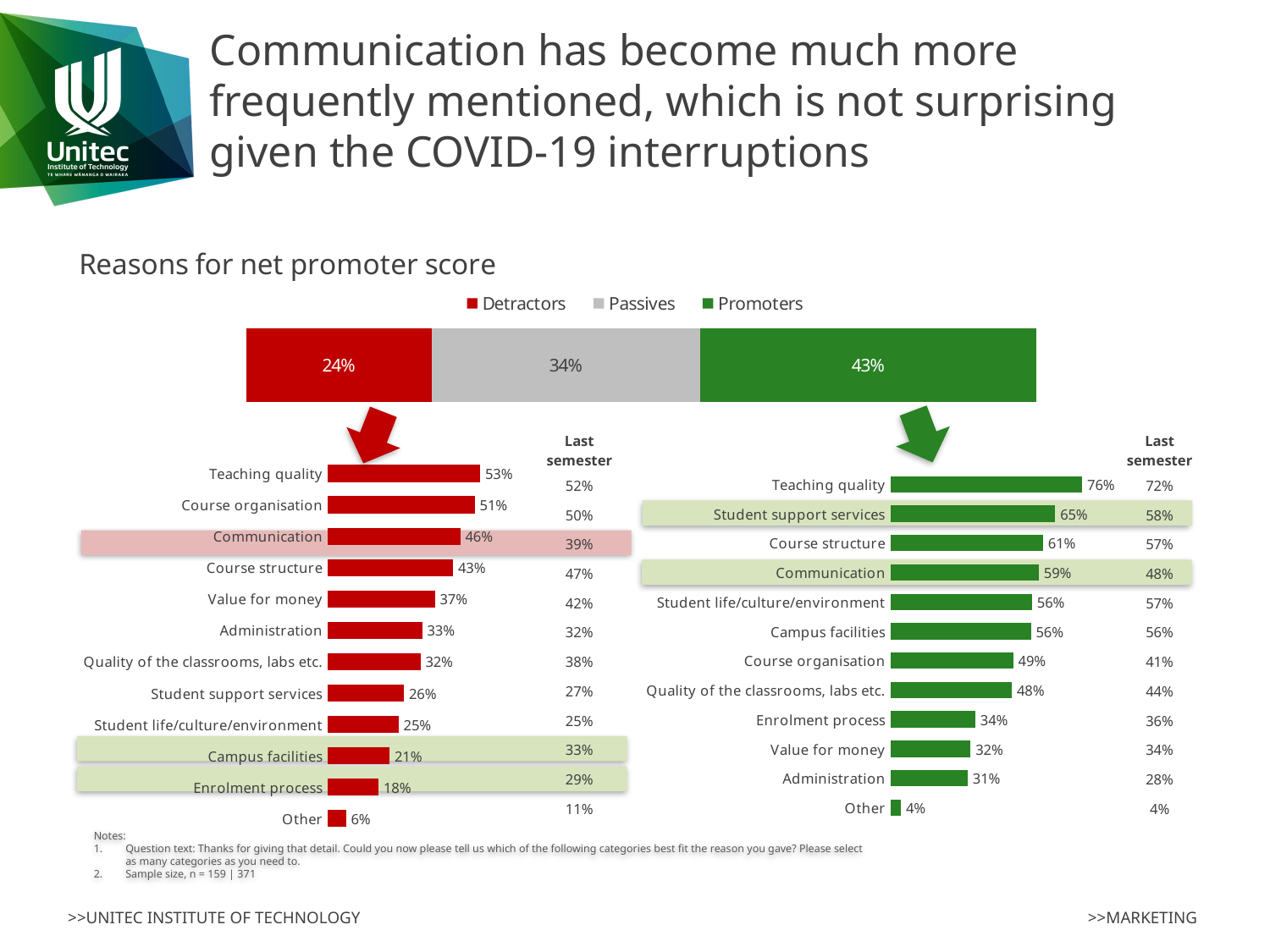
In the stacked bar at the top of the slide, what percentage are Promoters? 43% How many categories are shown in the left (red, Detractors) bar chart? 12 In the left (red, Detractors) bar chart, which category has the highest value? Teaching quality In the right (green, Promoters) bar chart, what was the Last semester value for Communication? 48% In the right (green, Promoters) bar chart, what is the value for Student support services? 65% In the right (green, Promoters) bar chart, what is the difference between Teaching quality and Course structure? 15% What type of chart is used for the Detractors and Promoters reasons? Bar chart In the right (green, Promoters) bar chart, which is larger: Course organisation or Enrolment process? Course organisation In the left (red, Detractors) bar chart, what is the value for Communication? 46% In the stacked bar at the top of the slide, what percentage are Passives? 34% In the left (red, Detractors) bar chart, which category has the lowest value? Other How many series does the legend of the top stacked bar list? 3